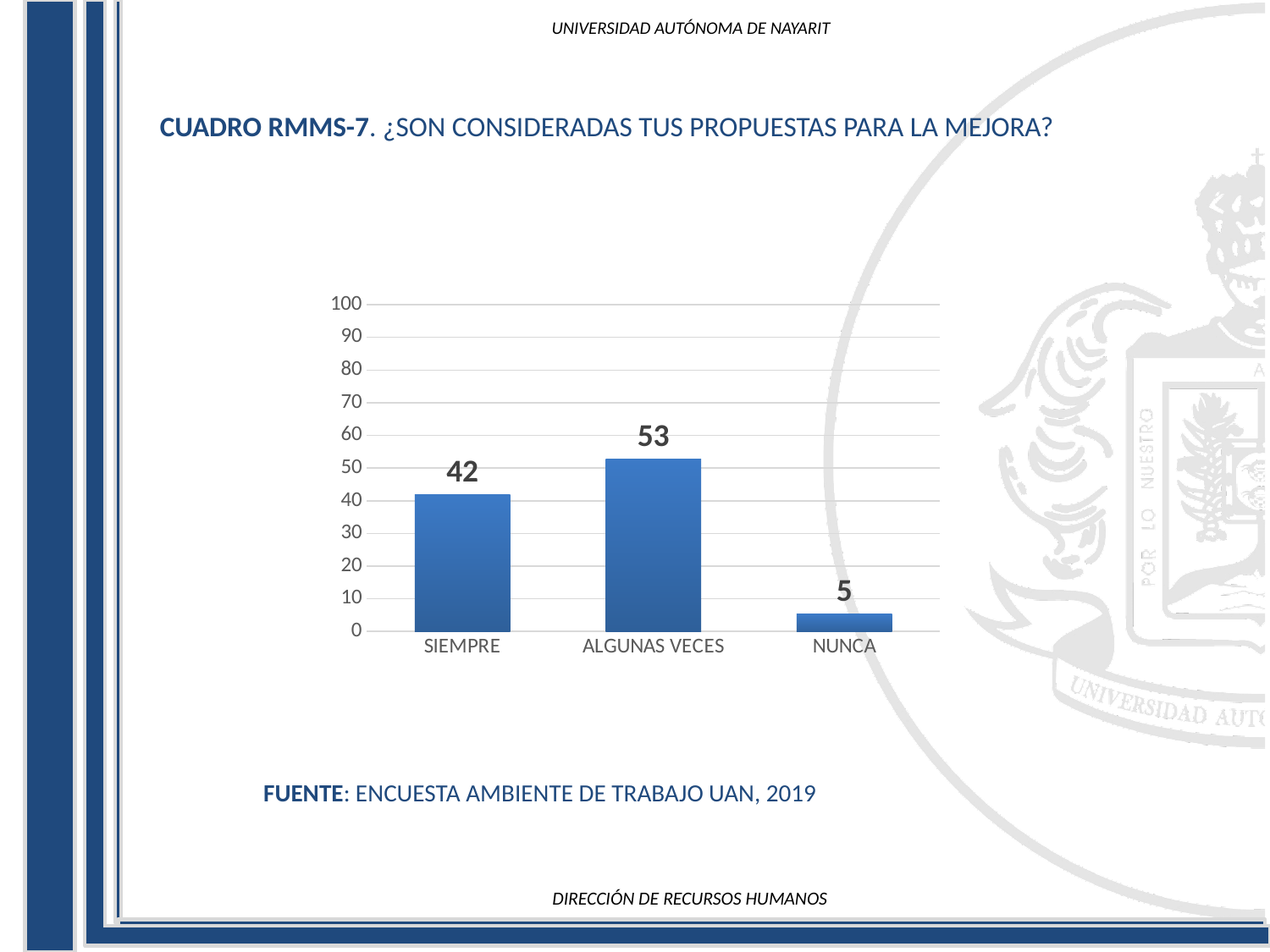
Which category has the lowest value? NUNCA What is the value for NUNCA? 5 What is the value for ALGUNAS VECES? 53 What is the difference between the values for ALGUNAS VECES and SIEMPRE? 11 What is the difference between the values for SIEMPRE and NUNCA? 37 What kind of chart is shown on the slide? bar chart Which category has the highest value? ALGUNAS VECES What is the value for SIEMPRE? 42 How many categories are shown on the x axis? 3 What is the maximum value shown on the vertical axis? 100 Is the value for ALGUNAS VECES greater or less than 50? greater Which is larger, the value for SIEMPRE or the value for NUNCA? SIEMPRE